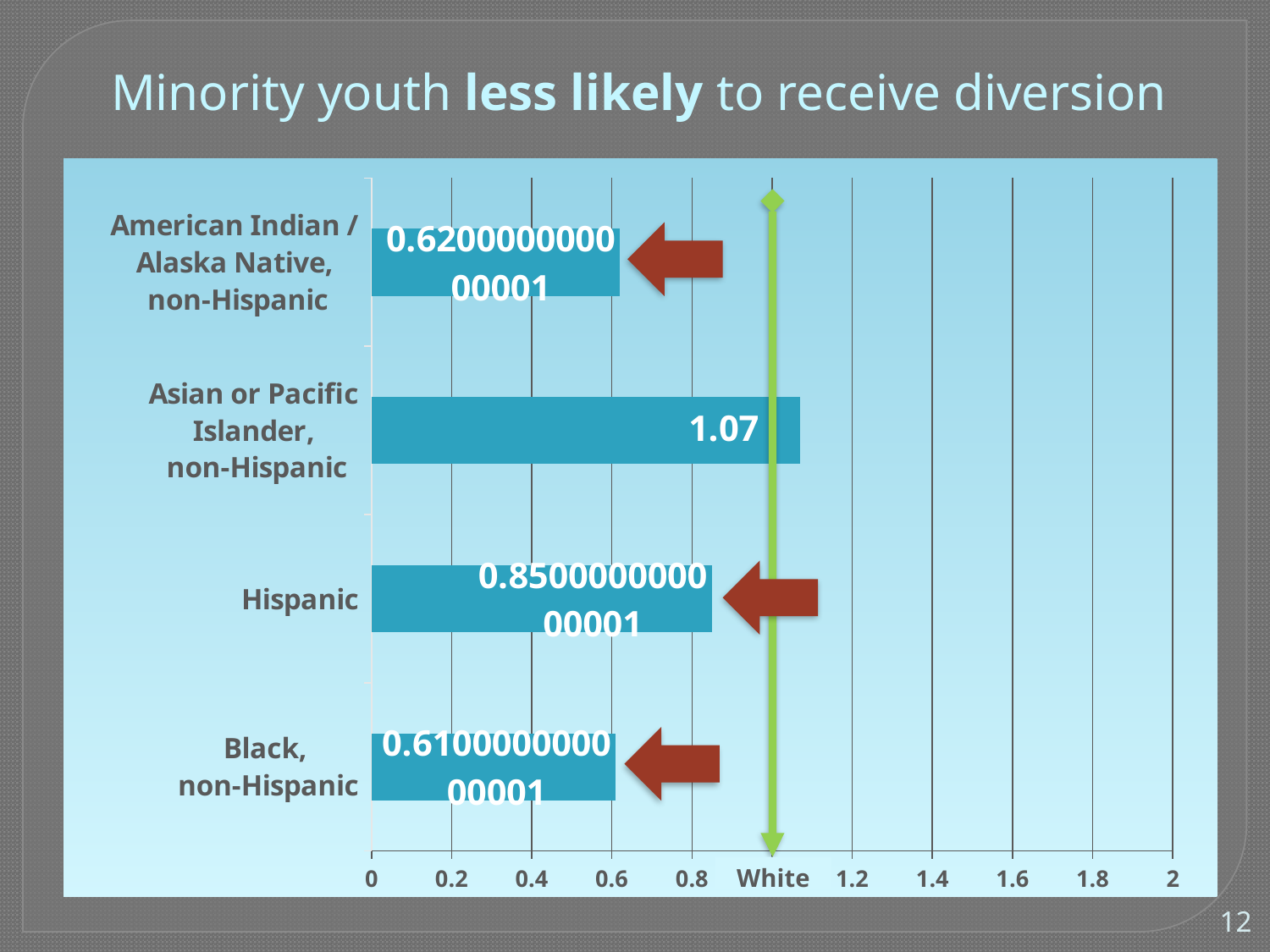
Is the value for Asian or Pacific Islander, non-Hispanic greater or less than 1? greater Which category has the lowest value? Black, non-Hispanic Which category has the highest value? Asian or Pacific Islander, non-Hispanic What kind of chart is shown on the slide? bar chart How many categories are shown in the chart? 4 What label is printed on the x axis at the position of the green vertical reference line? White Is the value for Hispanic greater or less than 0.8? greater What value is shown for Asian or Pacific Islander, non-Hispanic? 1.07 What value is shown for American Indian / Alaska Native, non-Hispanic? 0.620000000000001 What value is shown for Hispanic? 0.850000000000001 What value is shown for Black, non-Hispanic? 0.610000000000001 Which is larger, the value for Hispanic or the value for Black, non-Hispanic? Hispanic